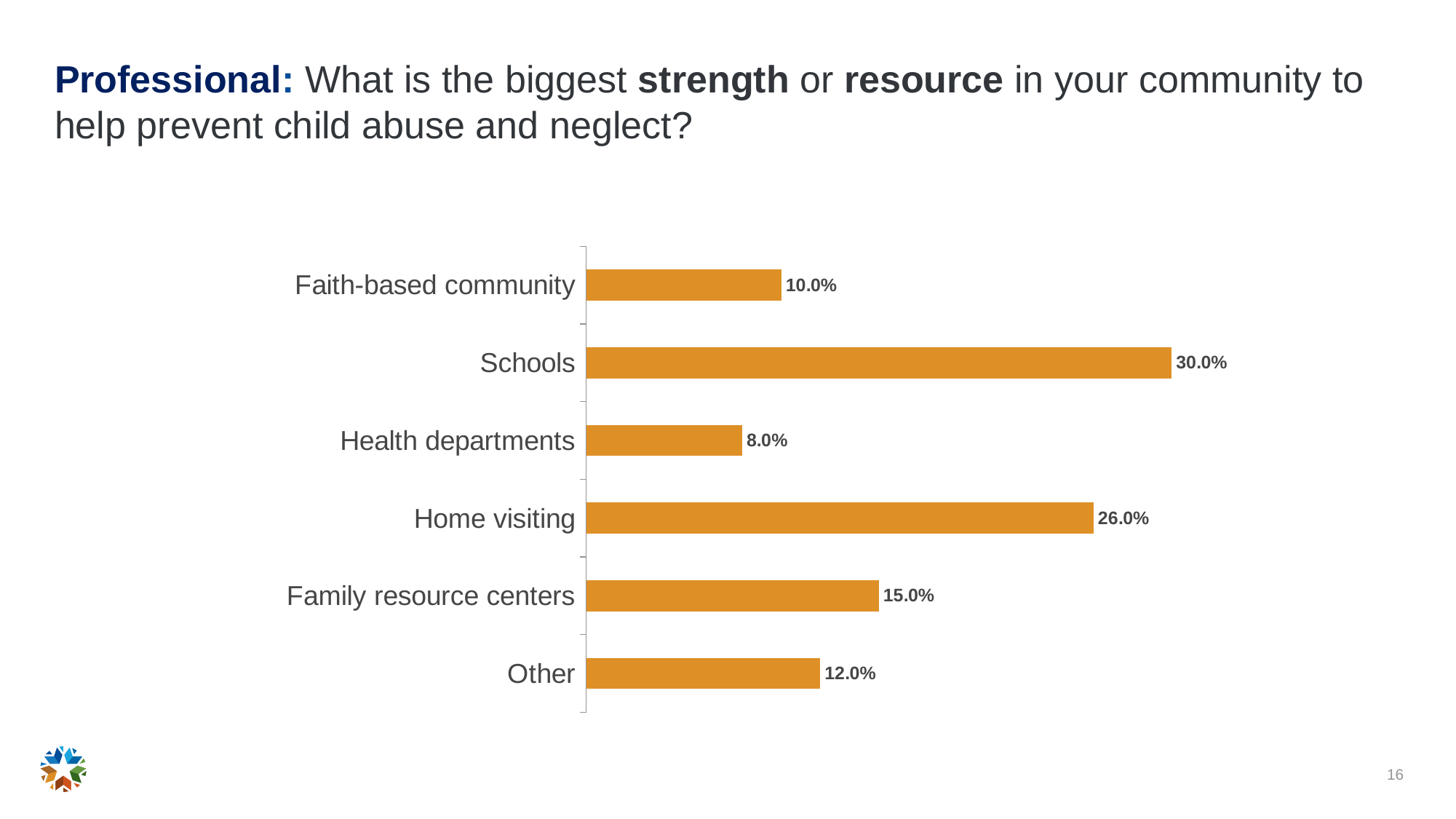
What is the value shown for Health departments? 8.0% Which has a larger value, Other or Faith-based community? Other What is the value shown for Home visiting? 26.0% What kind of chart is shown on the slide? Bar chart Which category has the lowest value? Health departments What colour are the bars in the chart? Orange What is the difference between the values for Family resource centers and Faith-based community? 5.0% What percentage of professionals chose Schools as the biggest strength or resource? 30.0% How many categories are shown in the chart? 6 What is the value shown for Family resource centers? 15.0% What is the difference between the values for Schools and Home visiting? 4.0% Which category has the highest value? Schools